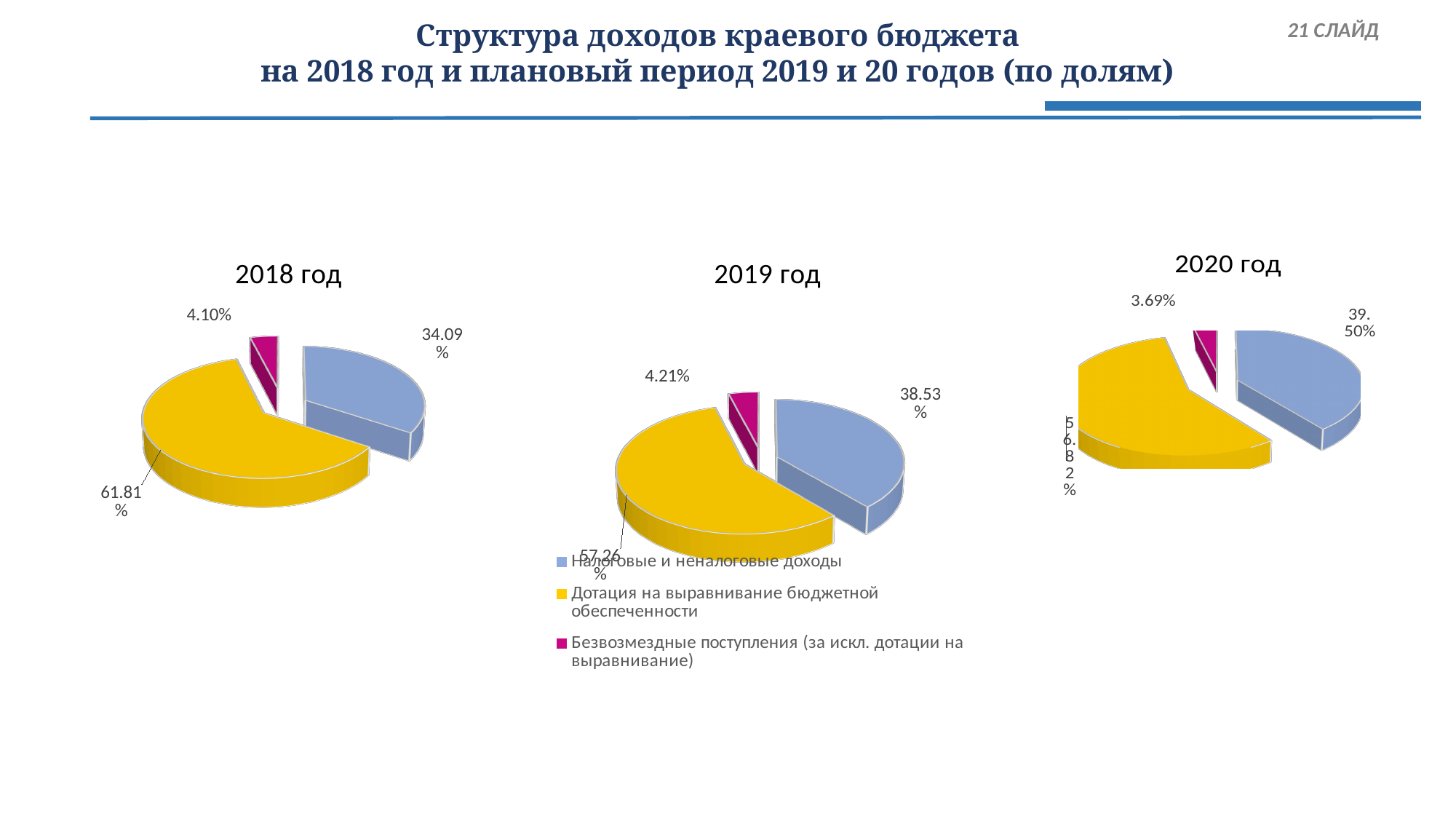
In the 2020 год chart, what share is shown for Налоговые и неналоговые доходы? 39.50% In the 2020 год chart, what share is shown for Безвозмездные поступления (за искл. дотации на выравнивание)? 3.69% In the 2018 год chart, what share is shown for Дотация на выравнивание бюджетной обеспеченности? 61.81% What kind of chart is used for the 2018 год chart? Pie chart In the 2018 год chart, which category has the smallest share? Безвозмездные поступления (за искл. дотации на выравнивание) What is the difference between the share of Налоговые и неналоговые доходы in the 2019 год chart and in the 2018 год chart? 4.44% In the 2019 год chart, what share is shown for Налоговые и неналоговые доходы? 38.53% In the 2018 год chart, what share is shown for Безвозмездные поступления (за искл. дотации на выравнивание)? 4.10% In the 2019 год chart, what share is shown for Дотация на выравнивание бюджетной обеспеченности? 57.26% How many series does the legend list? 3 In the 2019 год chart, which category has the largest share? Дотация на выравнивание бюджетной обеспеченности In the 2018 год chart, what share is shown for Налоговые и неналоговые доходы? 34.09%